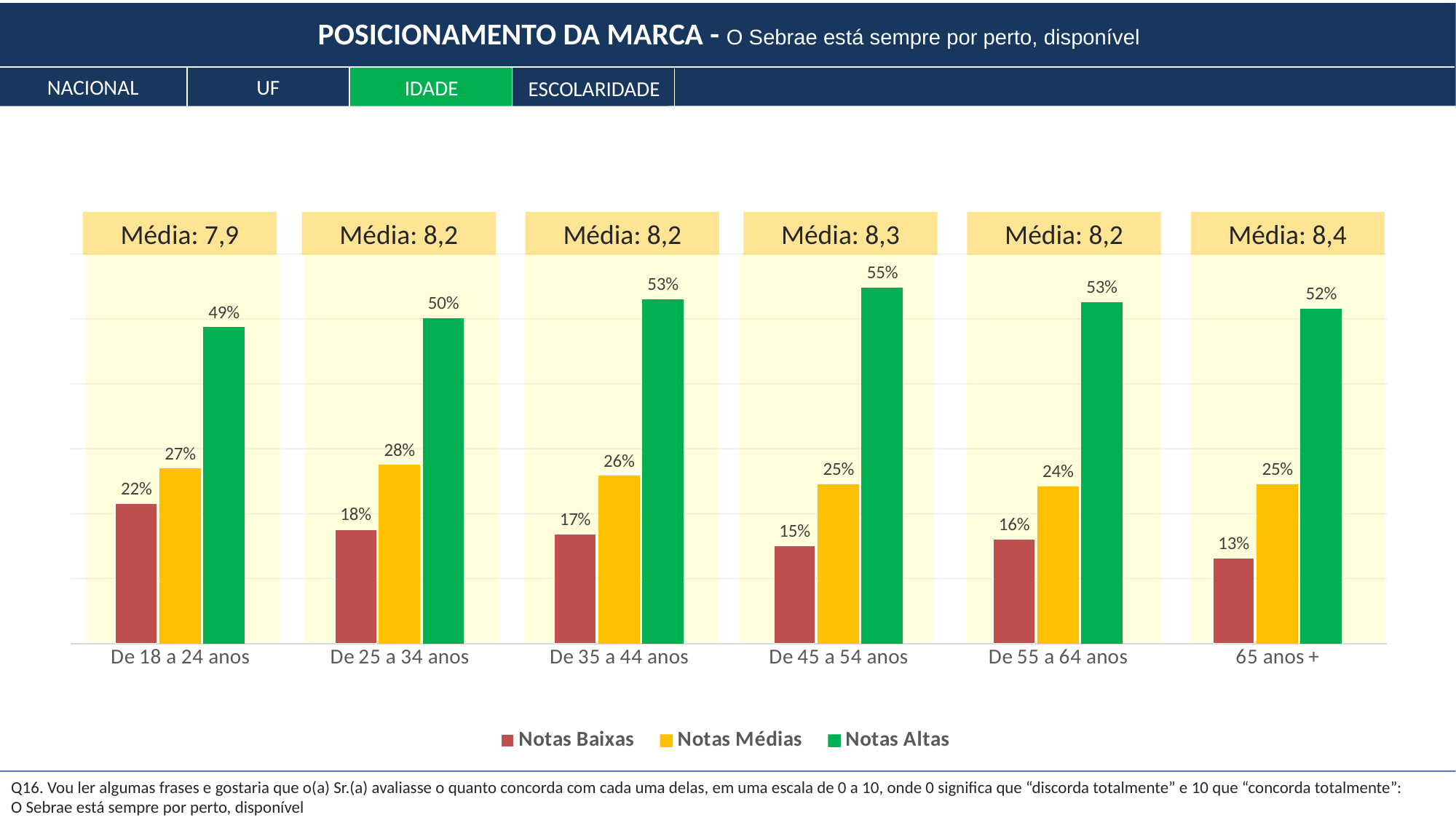
What is the value of Notas Médias for the 'De 25 a 34 anos' age group? 28% How many series does the legend list? 3 Which age group has the lowest Notas Baixas value? 65 anos + Which is larger: Notas Médias for 'De 35 a 44 anos' or Notas Médias for 'De 55 a 64 anos'? De 35 a 44 anos What kind of chart is shown on the slide? Bar chart Which age group has the highest Notas Altas value? De 45 a 54 anos What is the Média shown above the '65 anos +' age group? 8,4 What is the value of Notas Baixas for the '65 anos +' age group? 13% How many age groups are shown on the x axis? 6 Do the Notas Baixas values generally rise or fall from the youngest to the oldest age group? Fall What is the value of Notas Altas for the 'De 45 a 54 anos' age group? 55% What is the difference between Notas Altas and Notas Baixas for the 'De 18 a 24 anos' age group? 27%